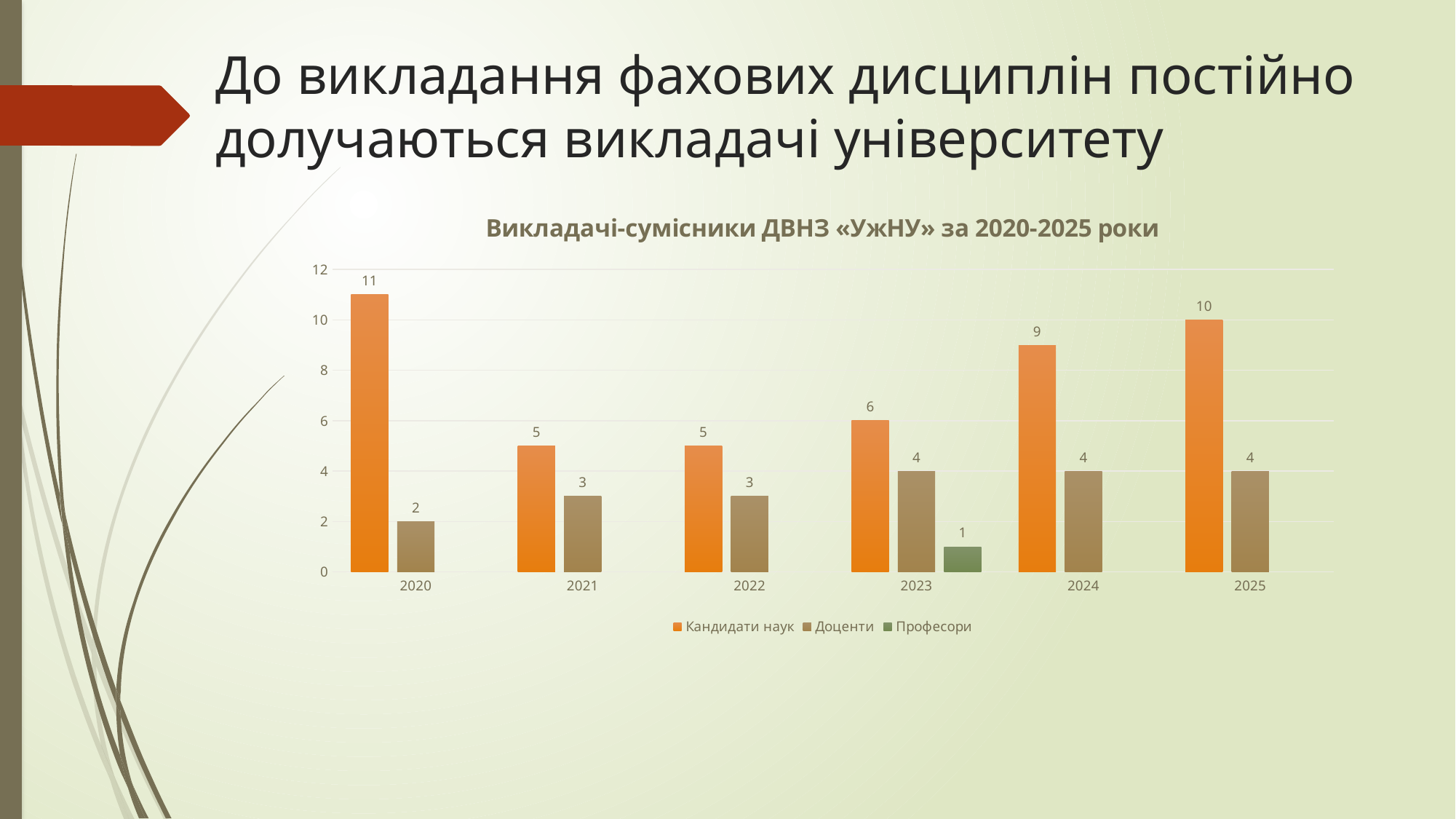
What is the value for Професори in 2023? 1 What kind of chart is shown on the slide? Bar chart What is the title of the chart? Викладачі-сумісники ДВНЗ «УжНУ» за 2020-2025 роки How many series does the legend list? 3 Which year has the highest value for Кандидати наук? 2020 Which year has the lowest value for Доценти? 2020 Which is larger: Кандидати наук in 2023 or Кандидати наук in 2021? Кандидати наук in 2023 What is the value for Кандидати наук in 2020? 11 Do the values for Кандидати наук rise or fall from 2022 to 2025? Rise How many years are shown on the x axis? 6 What is the difference between Кандидати наук in 2025 and in 2024? 1 What is the value for Доценти in 2023? 4